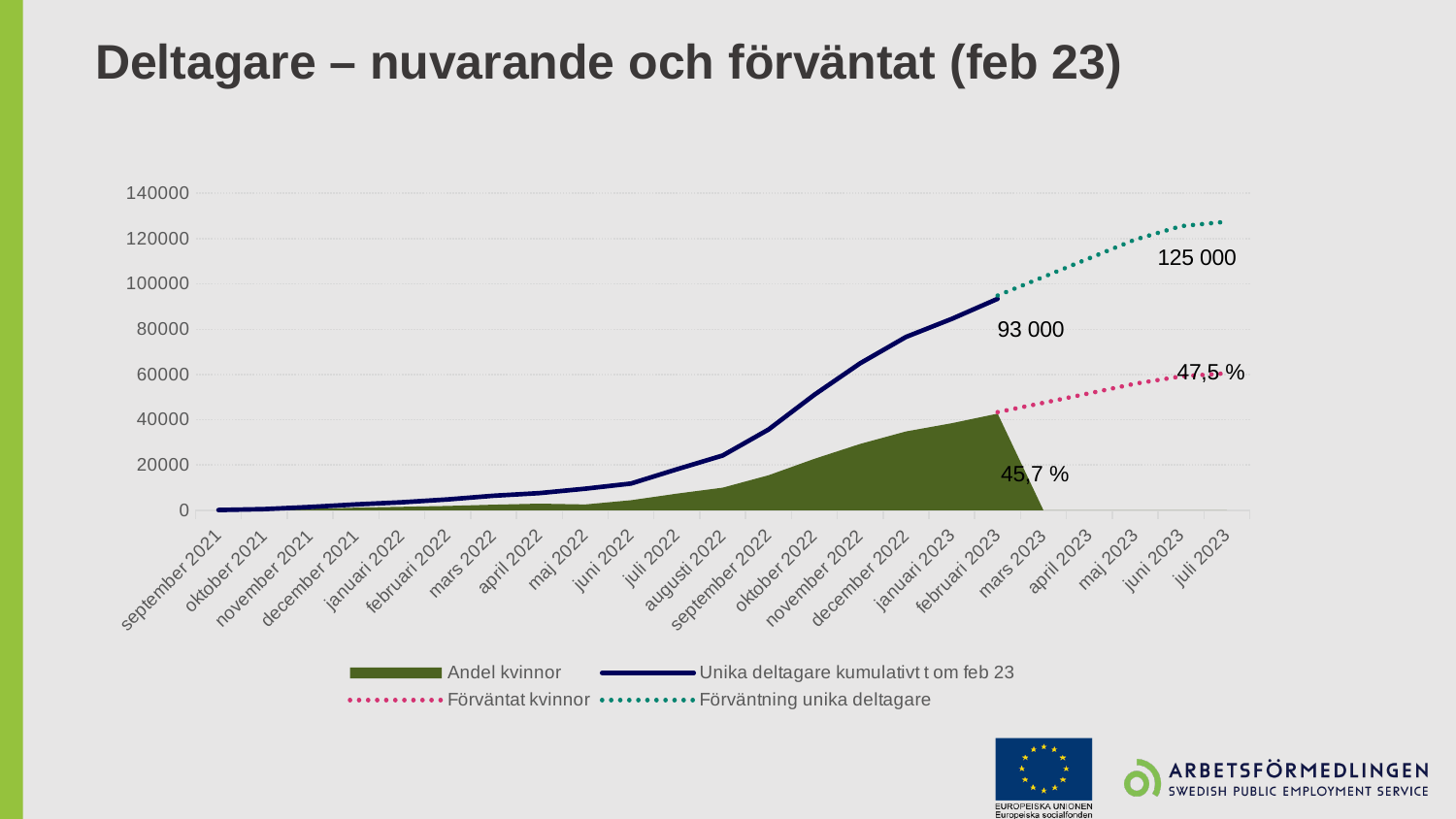
Which is larger: the Förväntat kvinnor share at juli 2023 or the Andel kvinnor share at februari 2023? Förväntat kvinnor at juli 2023 (47,5 %) What is the Andel kvinnor value labelled at februari 2023? 45,7 % How many months are shown on the x axis? 23 What is the value of Förväntning unika deltagare at juli 2023? 125 000 Is the value of Unika deltagare kumulativt t om feb 23 at oktober 2022 greater or less than 60000? less What is the title of the slide? Deltagare – nuvarande och förväntat (feb 23) What is the Förväntat kvinnor value labelled at juli 2023? 47,5 % What is the value of Unika deltagare kumulativt t om feb 23 at februari 2023? 93 000 Is the value of Unika deltagare kumulativt t om feb 23 at december 2022 greater or less than 60000? greater Does the Unika deltagare kumulativt t om feb 23 line rise or fall from september 2021 to februari 2023? rises How many series does the legend list? 4 What is the difference between the expected unique participants at juli 2023 (125 000) and the cumulative unique participants at februari 2023 (93 000)? 32 000